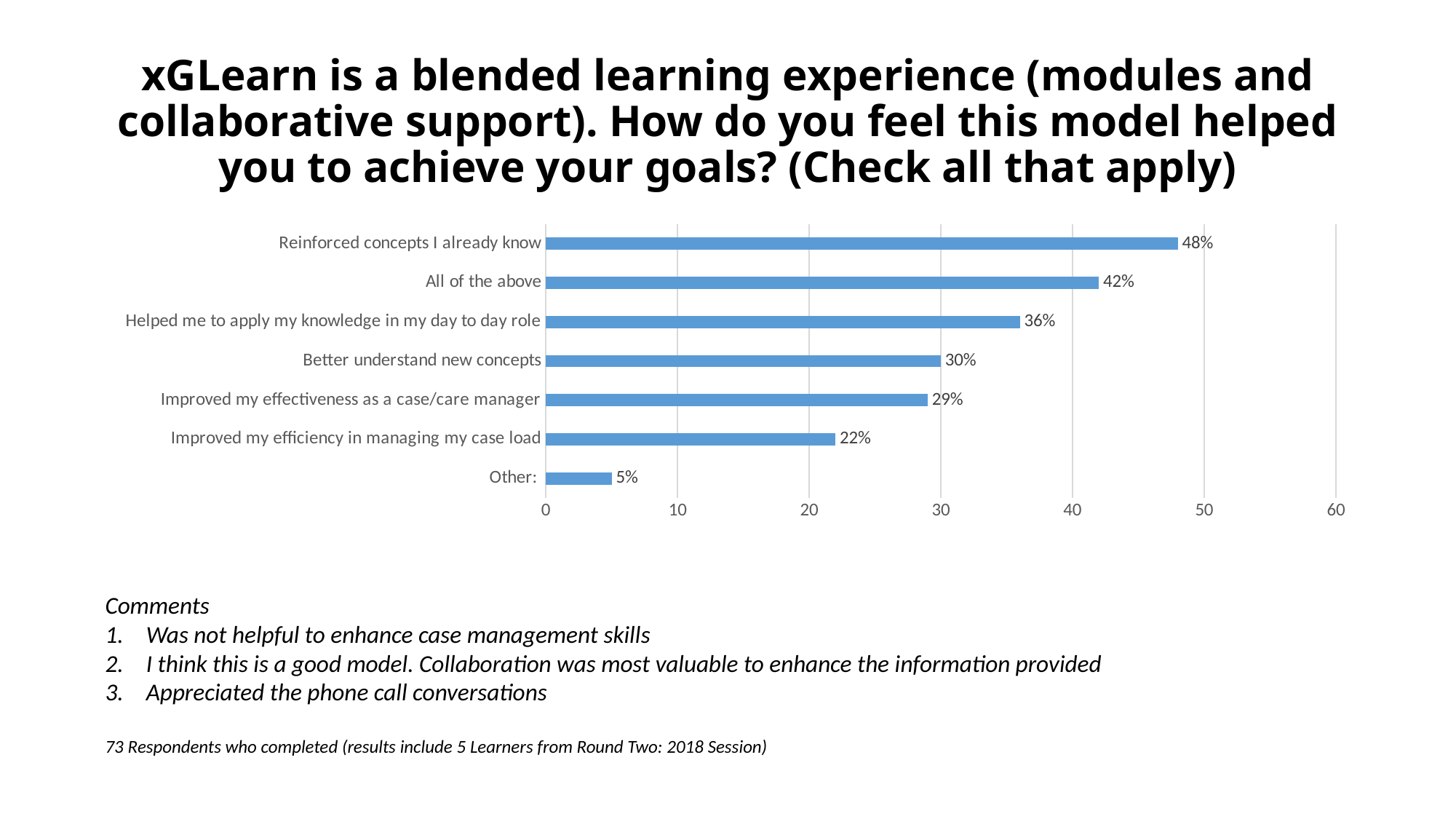
What is the value for "Improved my efficiency in managing my case load"? 22% Which is larger: "Better understand new concepts" or "Improved my efficiency in managing my case load"? Better understand new concepts What is the value for "All of the above"? 42% What percentage of respondents selected "Reinforced concepts I already know"? 48% What percentage selected "Helped me to apply my knowledge in my day to day role"? 36% What is the difference between "Better understand new concepts" and "Other:"? 25% What is the maximum value shown on the horizontal axis? 60 How many categories are shown in the chart? 7 Which category has the lowest value? Other: What kind of chart is shown on the slide? Bar chart What is the difference between "Reinforced concepts I already know" and "All of the above"? 6% Which category has the highest value? Reinforced concepts I already know